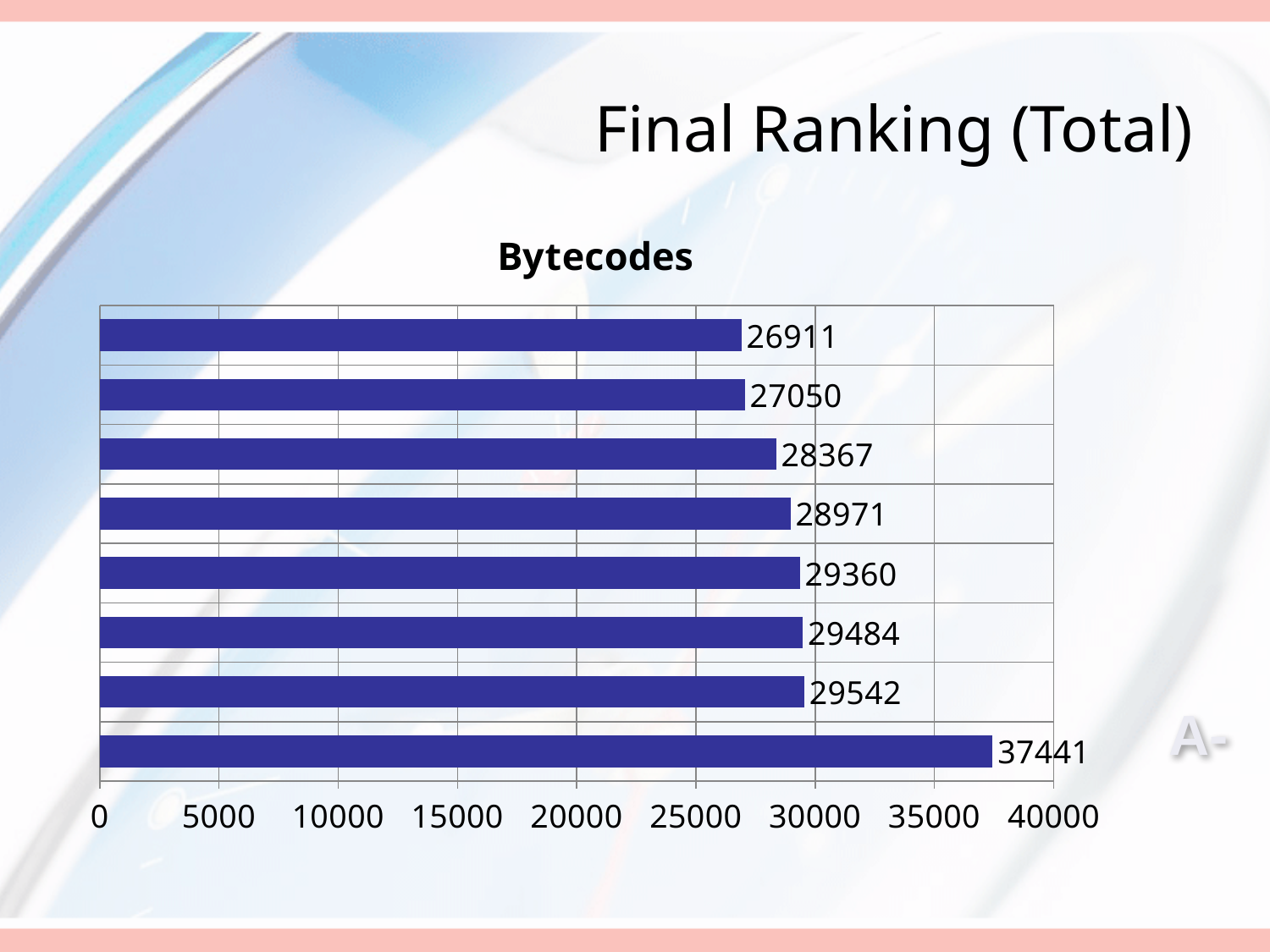
What is the value of the bottom bar? 37441 What kind of chart is shown on the slide? bar chart Which is larger, the bottom bar or the top bar? the bottom bar What is the difference between the bottom bar and the top bar? 10530 What is the highest value shown in the chart? 37441 What is the value of the third bar from the top? 28367 What is the value of the topmost bar? 26911 What is the title of the chart? Bytecodes What is the lowest value shown in the chart? 26911 Is the value of the bottom bar greater or less than 35000? greater Do the bar values increase or decrease going from the top bar to the bottom bar? increase How many bars are plotted in the chart? 8